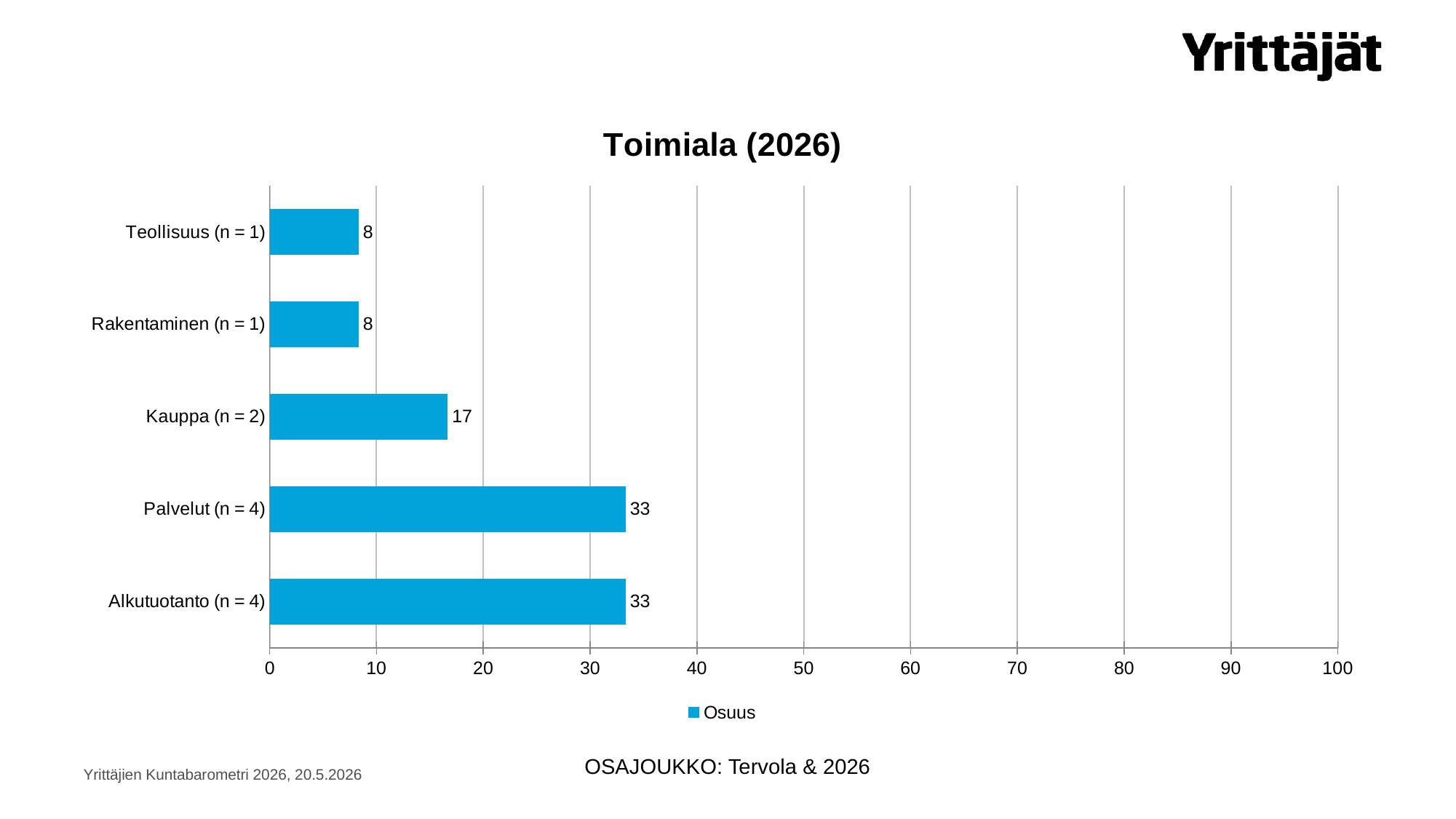
What is the value for Rakentaminen (n = 1)? 8 What kind of chart is shown on the slide? bar chart What is the difference between the values for Kauppa (n = 2) and Teollisuus (n = 1)? 9 How many categories are shown in the chart? 5 What is the value for Palvelut (n = 4)? 33 What is the title of the chart? Toimiala (2026) Is the value for Alkutuotanto (n = 4) greater or less than 20? greater What is the value for Teollisuus (n = 1)? 8 What is the value for Kauppa (n = 2)? 17 Which is larger, the value for Kauppa (n = 2) or the value for Rakentaminen (n = 1)? Kauppa (n = 2) What is the difference between the values for Palvelut (n = 4) and Kauppa (n = 2)? 16 How many series does the legend list? 1